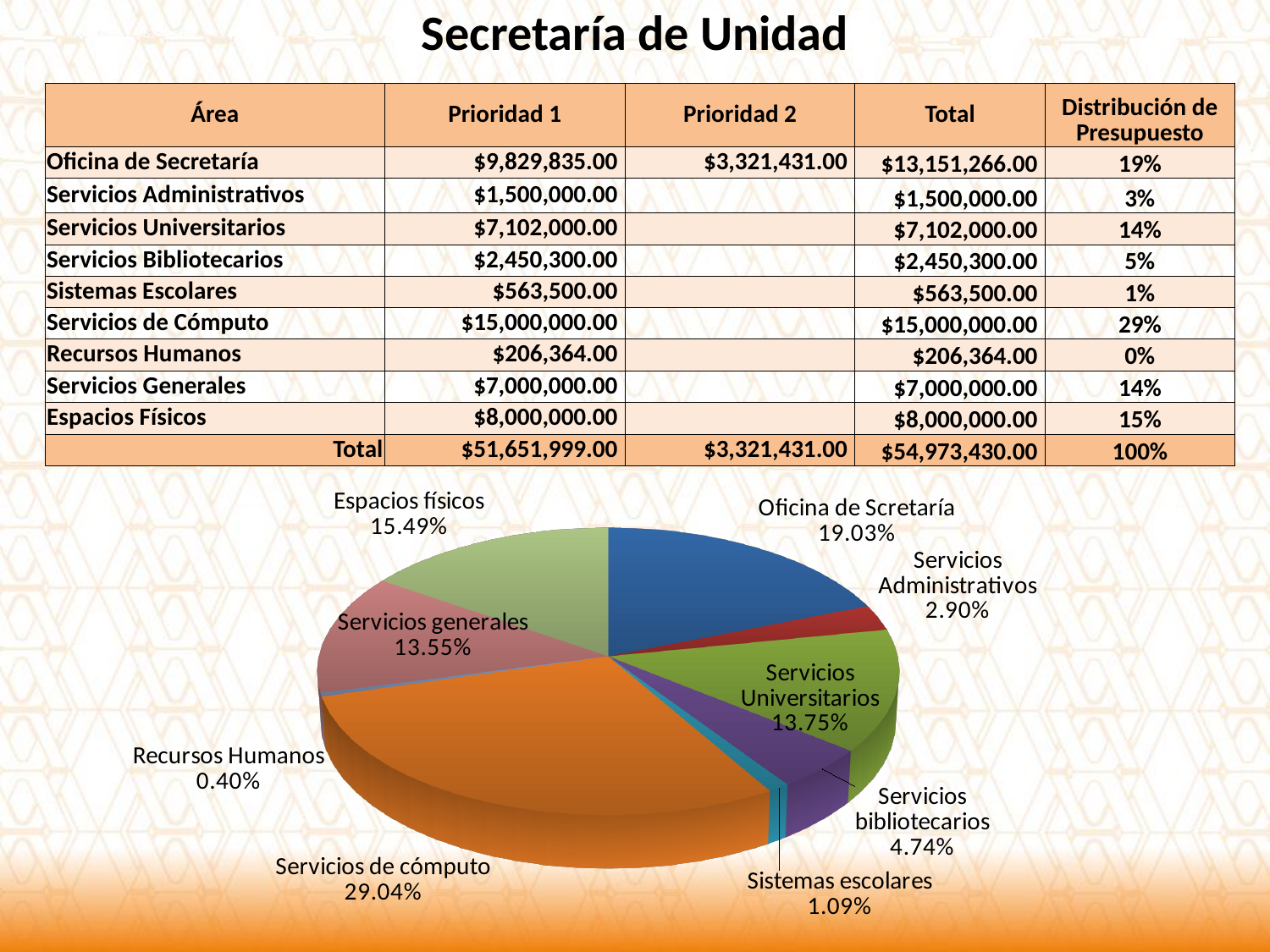
What type of chart is shown on the slide? pie chart What percentage does the pie chart show for Sistemas escolares? 1.09% How many slices does the pie chart have? 9 Which slice of the pie chart is the smallest? Recursos Humanos What percentage does the pie chart show for Oficina de Scretaría? 19.03% What is the difference in percentage points between Servicios de cómputo and Oficina de Scretaría in the pie chart? 10.01 Which slice of the pie chart is the largest? Servicios de cómputo In the pie chart, which is larger: Servicios Universitarios or Servicios generales? Servicios Universitarios What colour is the Servicios de cómputo slice in the pie chart? orange What percentage does the pie chart show for Espacios físicos? 15.49% What percentage does the pie chart show for Servicios de cómputo? 29.04% What percentage does the pie chart show for Servicios bibliotecarios? 4.74%